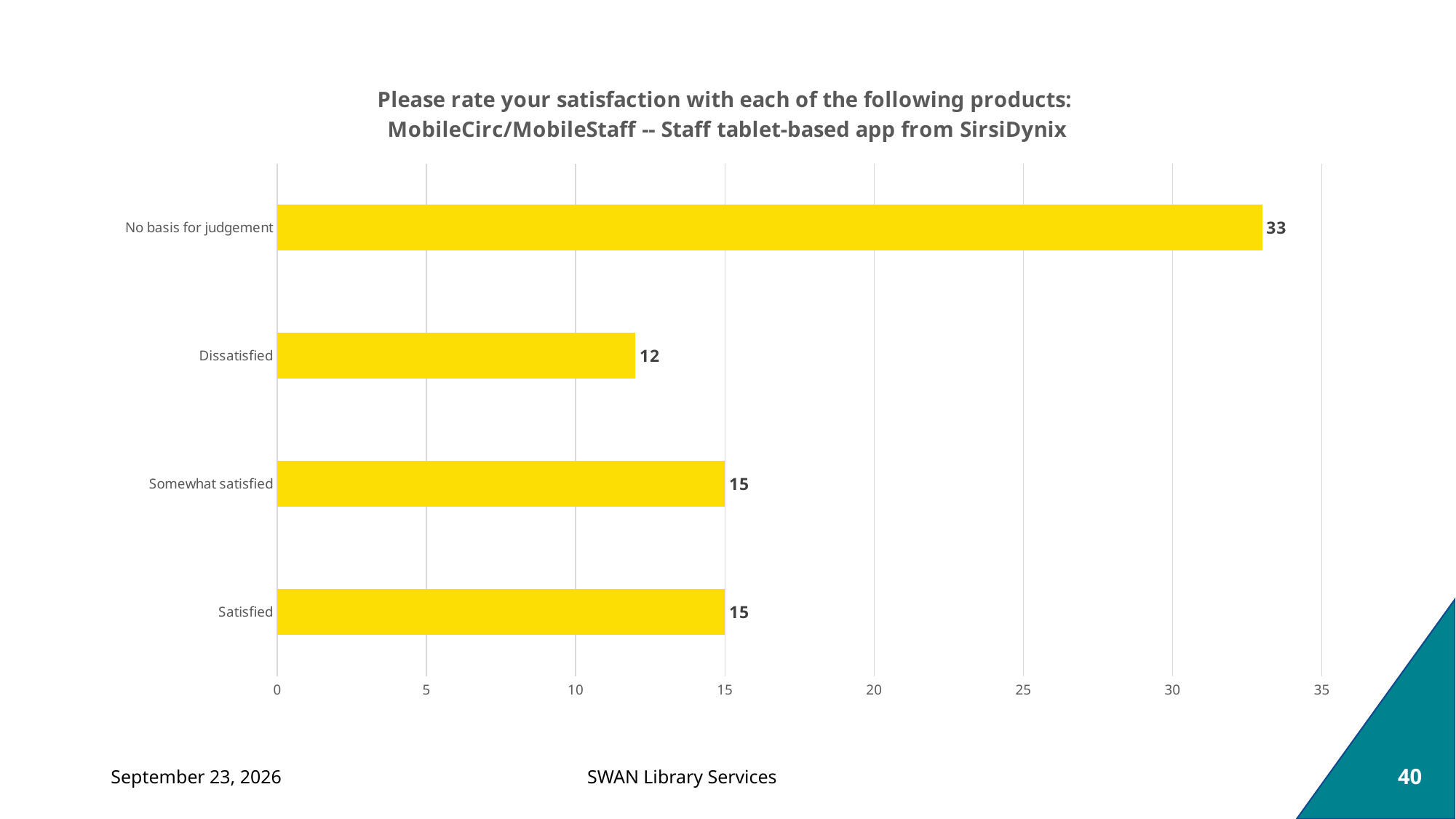
What is the value for "Dissatisfied"? 12 What kind of chart is shown on the slide? Bar chart Is the value for "No basis for judgement" greater or less than 30? greater What is the value for "Satisfied"? 15 What is the value for "No basis for judgement"? 33 What is the value for "Somewhat satisfied"? 15 Which category has the highest value? No basis for judgement What is the difference between the values for "No basis for judgement" and "Dissatisfied"? 21 How many categories are shown in the chart? 4 Which category has the lowest value? Dissatisfied What is the difference between the values for "Satisfied" and "Dissatisfied"? 3 Which is larger, the value for "Somewhat satisfied" or the value for "Dissatisfied"? Somewhat satisfied